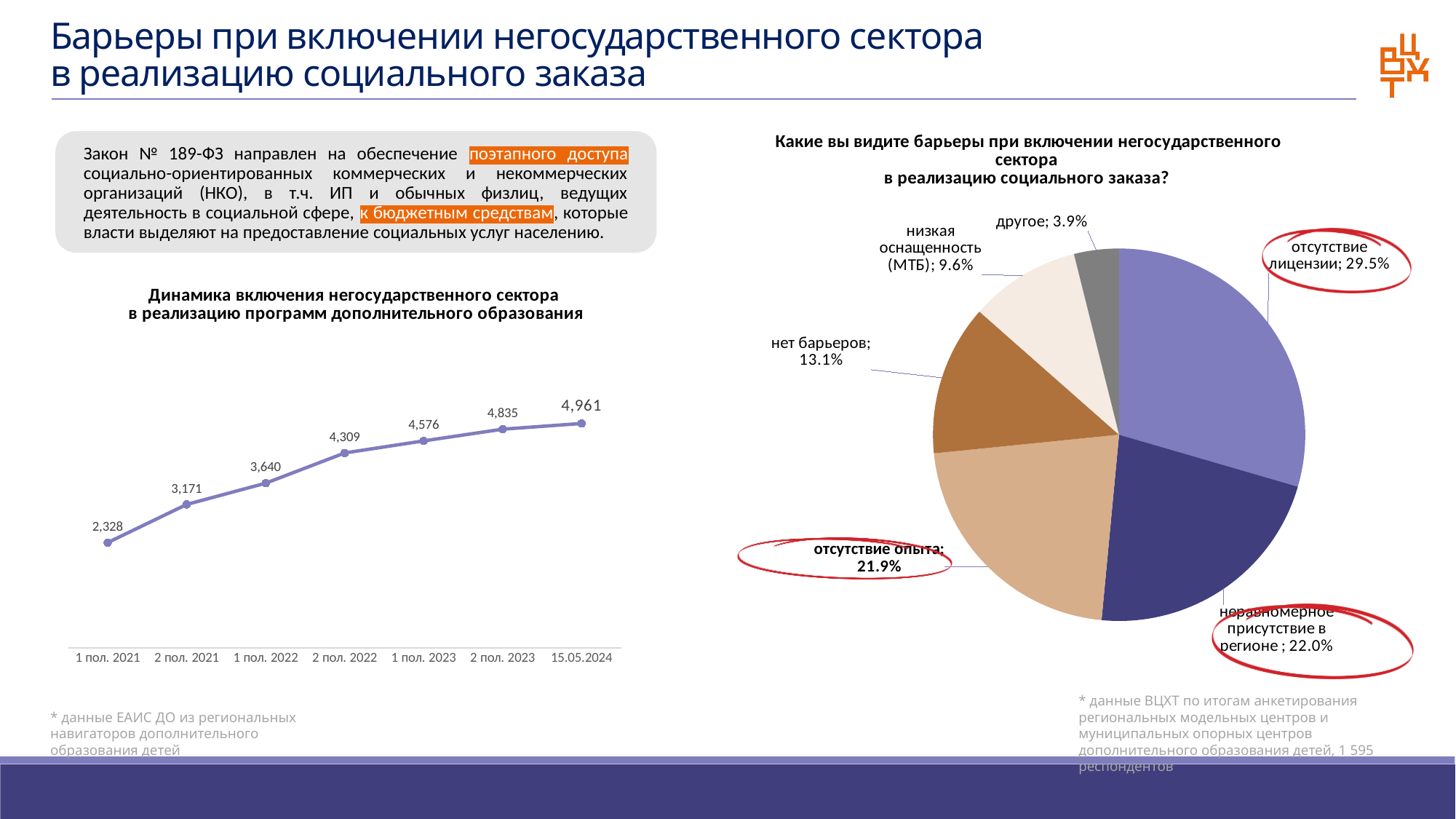
In the line chart on the left, which period has the lowest value? 1 пол. 2021 In the pie chart on the right, which slice is the smallest? другое In the pie chart on the right, which barrier has the largest share? отсутствие лицензии What type of chart is the chart on the left of the slide? line chart In the line chart on the left, do the values rise or fall from 1 пол. 2021 to 15.05.2024? rise In the line chart on the left, what is the value for 15.05.2024? 4,961 In the line chart on the left, how many data points are plotted? 7 In the pie chart on the right, what share is labelled for 'отсутствие лицензии'? 29.5% In the pie chart on the right, how many slices are there? 6 In the line chart on the left, what is the value for 1 пол. 2021? 2,328 In the line chart on the left, what is the value for 2 пол. 2022? 4,309 In the line chart on the left, what is the difference between the values for 2 пол. 2023 and 1 пол. 2023? 259